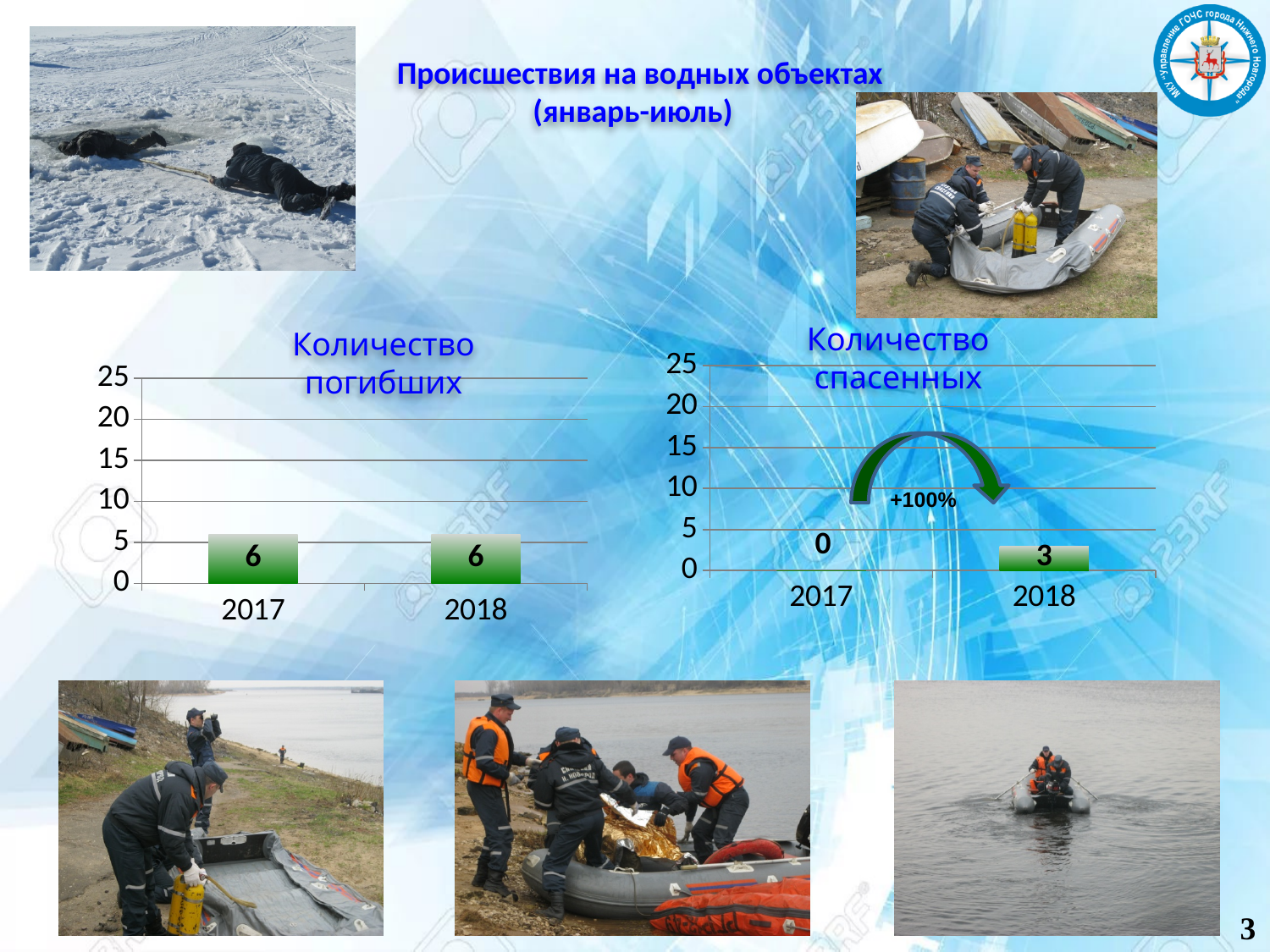
In the chart titled "Количество спасенных", which year has the higher value? 2018 How many categories are shown on the x axis of the chart titled "Количество спасенных"? 2 In the chart titled "Количество спасенных", what is the value for 2017? 0 What kind of chart is the chart titled "Количество погибших"? bar chart In the chart titled "Количество погибших", what is the difference between the 2017 and 2018 values? 0 In the chart titled "Количество погибших", what is the value for 2017? 6 In the chart titled "Количество спасенных", what is the value for 2018? 3 In the chart titled "Количество спасенных", what percentage change is printed on the arrow between 2017 and 2018? +100% In the chart titled "Количество спасенных", what is the difference between the 2018 and 2017 values? 3 In the chart titled "Количество спасенных", which year has the lowest value? 2017 In the chart titled "Количество погибших", is the value for 2018 greater or less than 10? less In the chart titled "Количество погибших", what is the value for 2018? 6